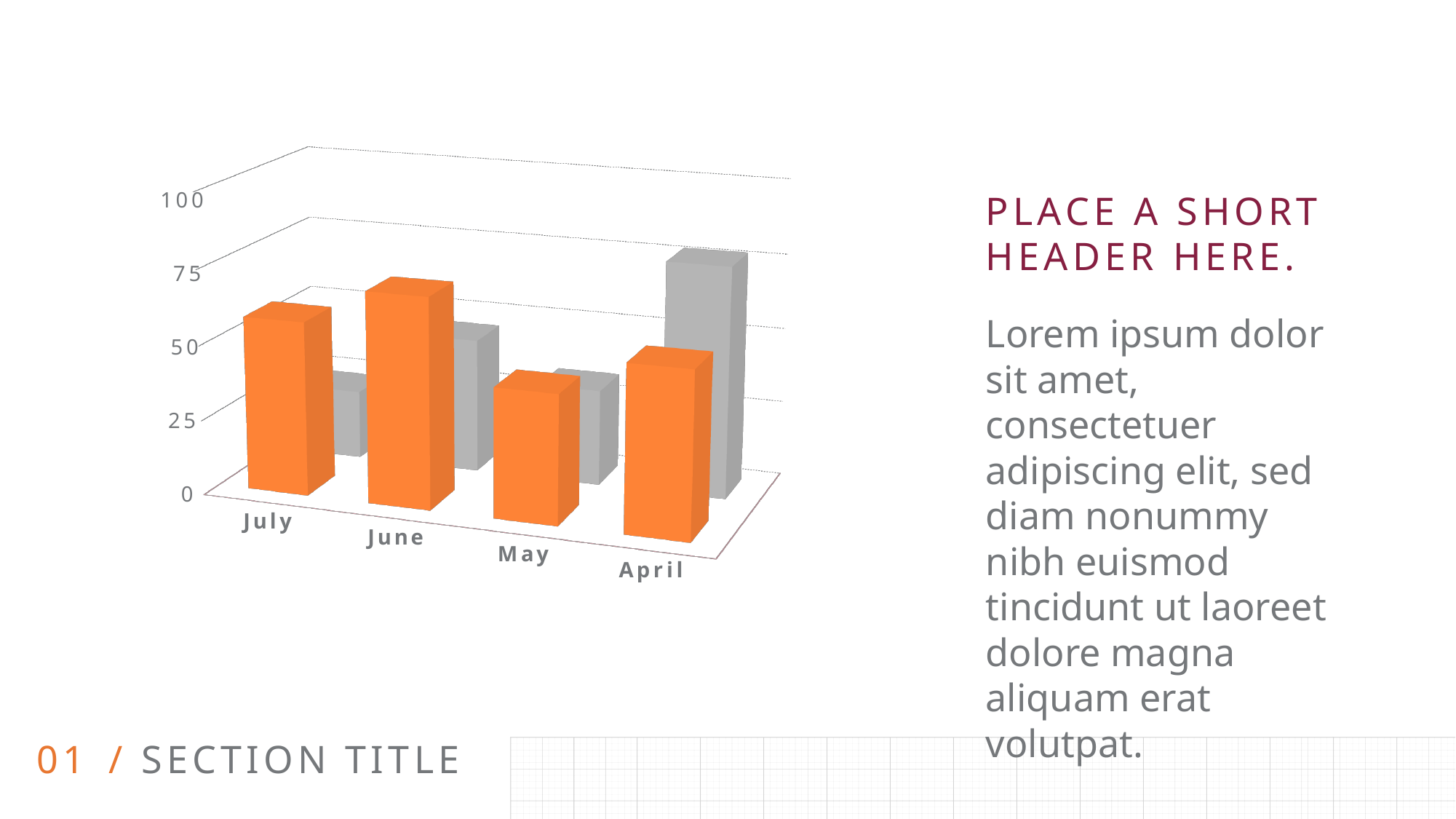
What two colours are used for the bars in the chart? orange and gray Is the gray bar for July greater or less than 50? less Which month has the shortest gray bar? July Which month has the tallest gray bar? April For April, which bar is taller, the orange one or the gray one? gray Is the gray bar for April greater or less than 50? greater Which month has the shortest orange bar? May Which month has the tallest orange bar? June What kind of chart is shown on the slide? bar chart How many bars are plotted for each month in the chart? 2 Is the orange bar for June greater or less than 50? greater How many categories are shown on the x axis of the chart? 4